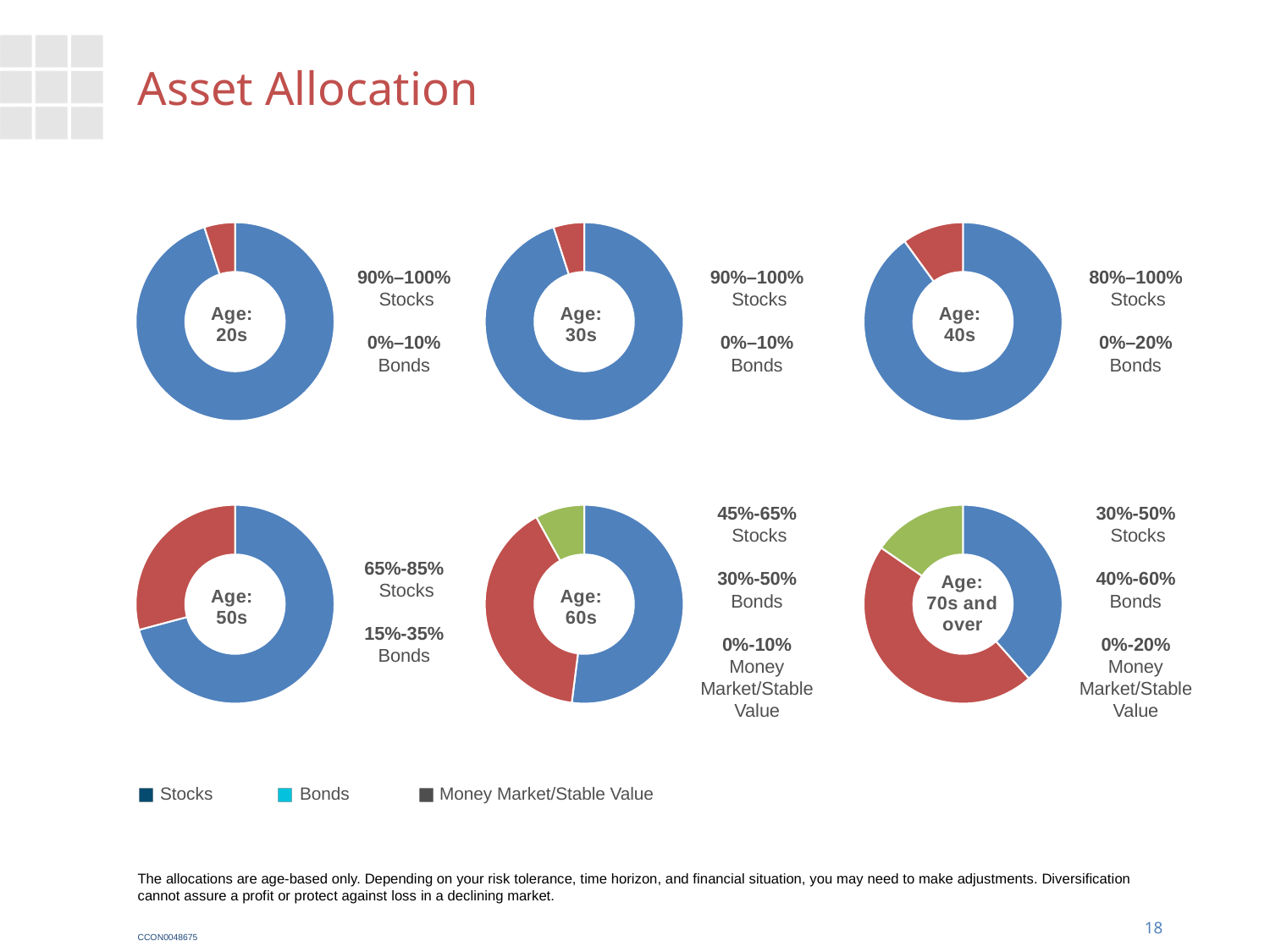
In the Age: 20s chart, what is the stated range for Stocks? 90%–100% In the Age: 70s and over chart, which category has the smallest slice? Money Market/Stable Value In the Age: 40s chart, what is the stated range for Bonds? 0%–20% In the Age: 50s chart, what is the stated range for Stocks? 65%-85% In the Age: 50s chart, which slice is larger, Stocks or Bonds? Stocks In the Age: 70s and over chart, what is the stated range for Bonds? 40%-60% What kind of chart is used to show the allocation for each age group on this slide? Donut (pie) chart How many donut charts are shown on the slide? 6 In the Age: 60s chart, how many slices does the donut have? 3 What is the title of the slide containing these charts? Asset Allocation In the Age: 60s chart, what is the stated range for Money Market/Stable Value? 0%-10% How many entries does the legend at the bottom of the slide list? 3